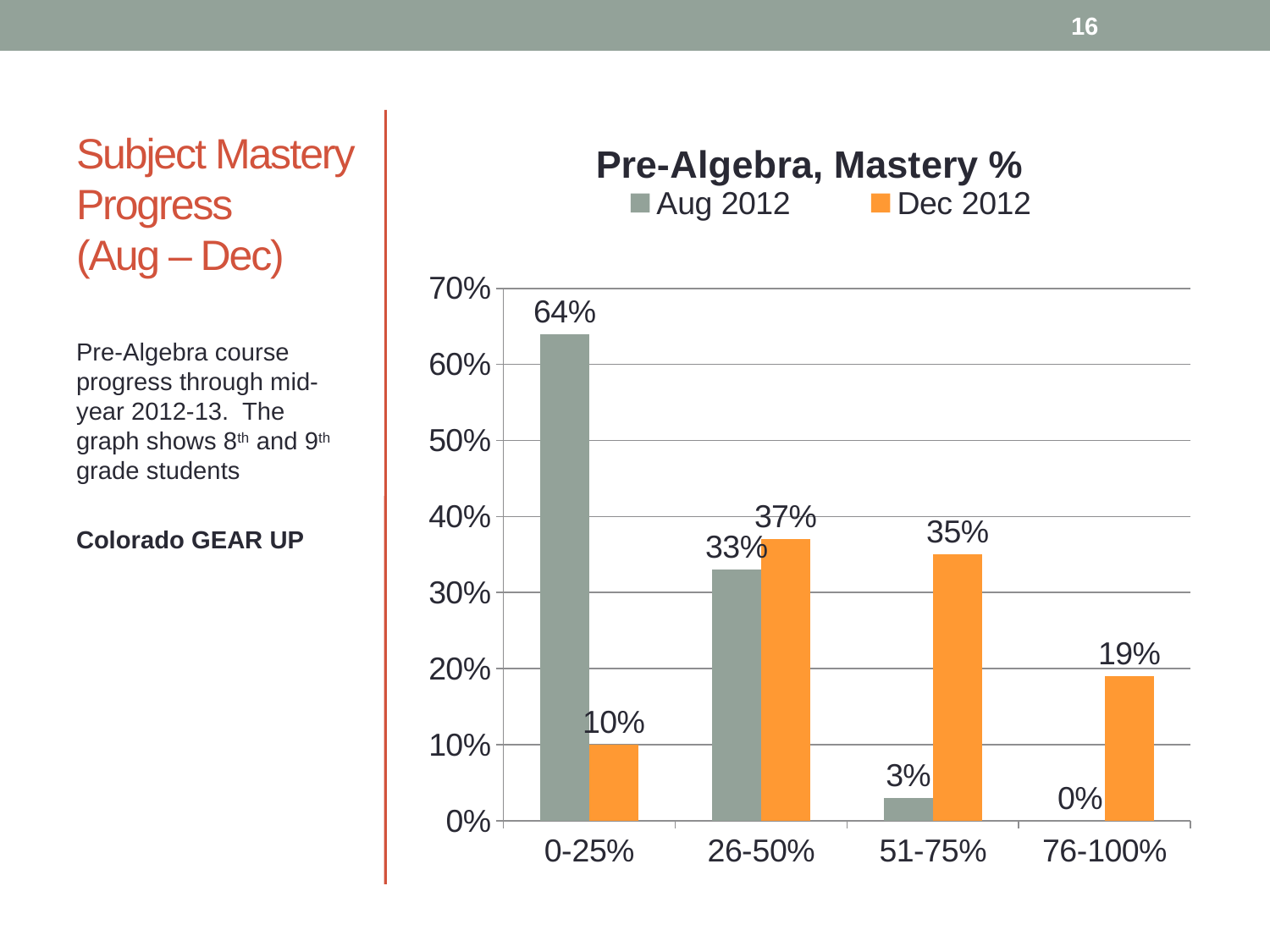
What is the Dec 2012 value for the 51-75% category? 35% What kind of chart is shown on the slide? Bar chart What is the title of the chart? Pre-Algebra, Mastery % How many categories are shown on the x axis? 4 Which is larger for the 26-50% category, the Aug 2012 value or the Dec 2012 value? Dec 2012 What is the difference between the Aug 2012 and Dec 2012 values for the 0-25% category? 54% Do the Aug 2012 values rise or fall from the 0-25% category to the 76-100% category? Fall What is the Dec 2012 value for the 76-100% category? 19% What is the Aug 2012 value for the 0-25% category? 64% How many series does the legend list? 2 Which category has the highest Aug 2012 value? 0-25% Which category has the lowest Dec 2012 value? 0-25%